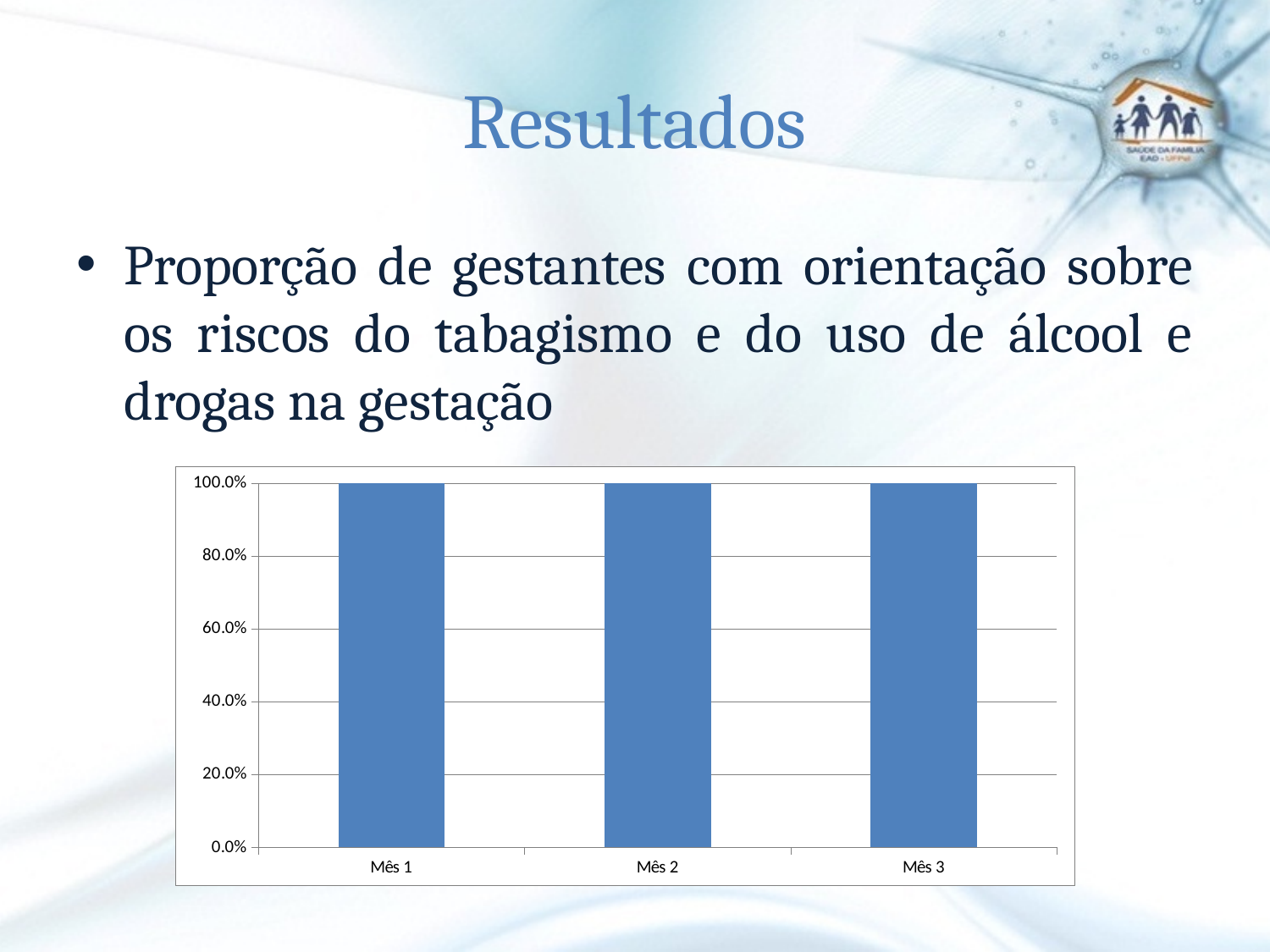
What is the highest value shown on the y axis of the chart? 100.0% Is the value for Mês 3 greater or less than 60.0%? greater What is the value for Mês 3? 100.0% Is the value for Mês 1 greater or less than 80.0%? greater What are the category labels on the x axis of the chart? Mês 1, Mês 2, Mês 3 What kind of chart is shown on the slide? bar chart What is the value for Mês 2? 100.0% What is the difference between the values for Mês 1 and Mês 2? 0.0% What is the value for Mês 1? 100.0% Do the values rise, fall, or stay the same from Mês 1 to Mês 3? stay the same How many categories are shown on the x axis of the chart? 3